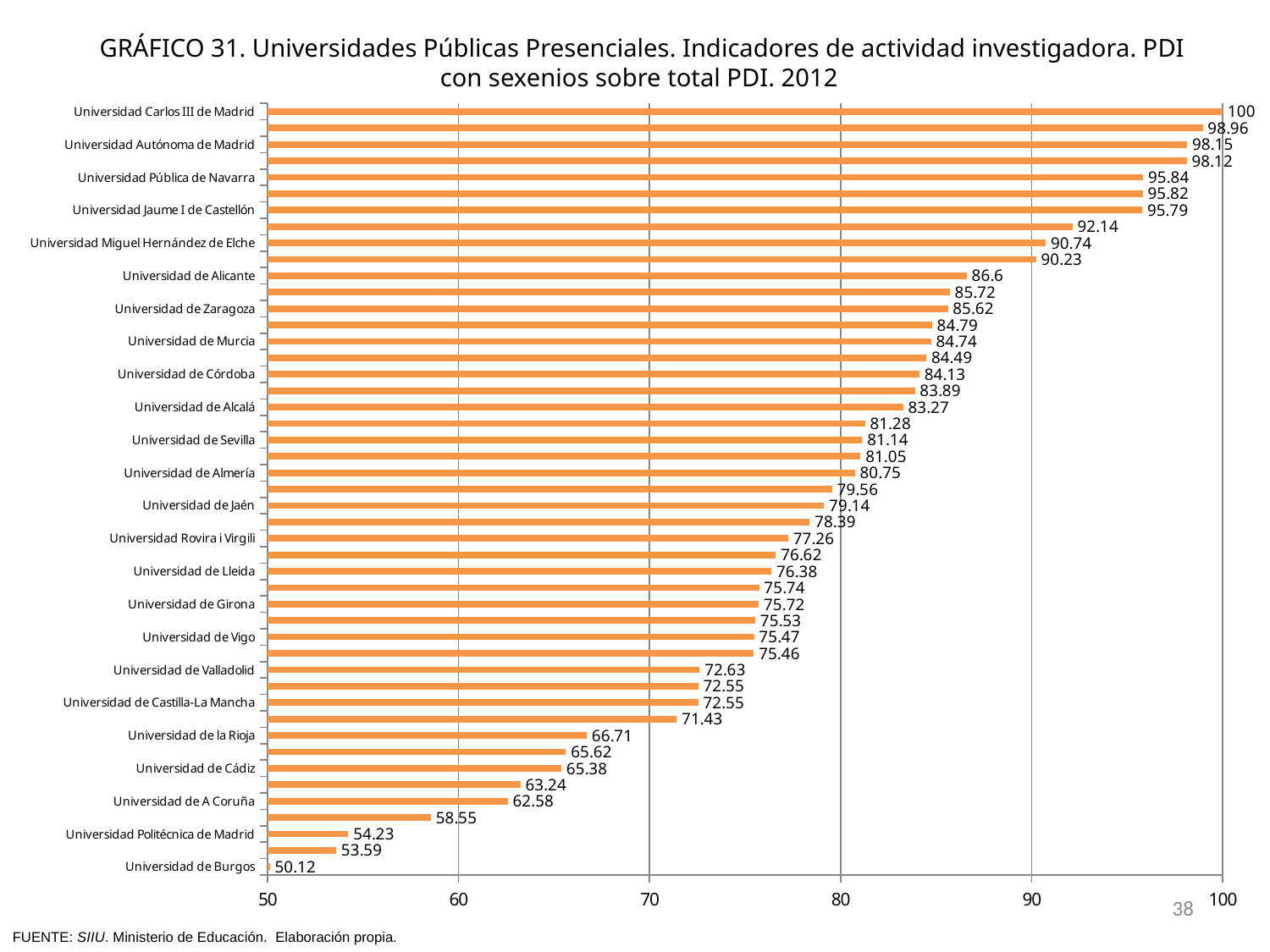
What kind of chart is shown on the slide? bar chart Is the value for Universidad de la Rioja greater or less than 70? less What is the value for Universidad Politécnica de Madrid? 54.23 What is the difference between the values for Universidad Autónoma de Madrid and Universidad de Cádiz? 32.77 Which is larger, the value for Universidad de Zaragoza or the value for Universidad de Sevilla? Universidad de Zaragoza What is the value for Universidad de Burgos? 50.12 What year does the chart title refer to? 2012 What is the value for Universidad de Alicante? 86.6 What is the value for Universidad Carlos III de Madrid? 100 Which university has the highest value? Universidad Carlos III de Madrid Which university has the lowest value? Universidad de Burgos What is the value for Universidad de Vigo? 75.47